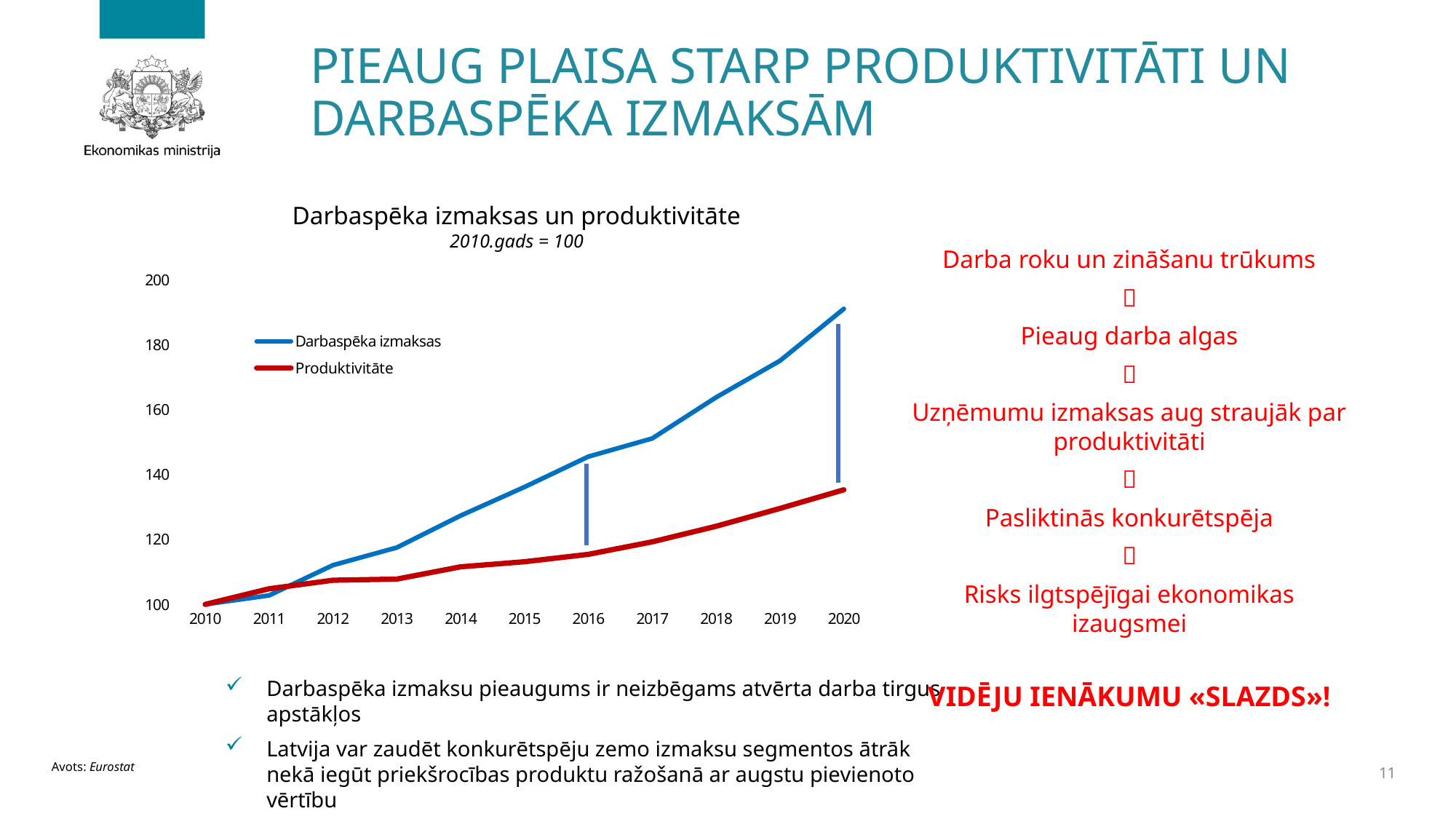
What is the title of the chart? Darbaspēka izmaksas un produktivitāte How many years are shown on the x axis of the chart? 11 Is the value for Darbaspēka izmaksas in 2020 greater or less than 180? greater What kind of chart is shown on the slide? line chart Is the value for Produktivitāte in 2020 greater or less than 140? less Is the value for Produktivitāte in 2016 greater or less than 120? less How many series does the chart legend list? 2 Which series has the higher value in 2020, Darbaspēka izmaksas or Produktivitāte? Darbaspēka izmaksas What colour is the Produktivitāte line in the chart? red What is the value of Darbaspēka izmaksas in 2010? 100 Does the Produktivitāte line rise or fall from 2010 to 2020? rise